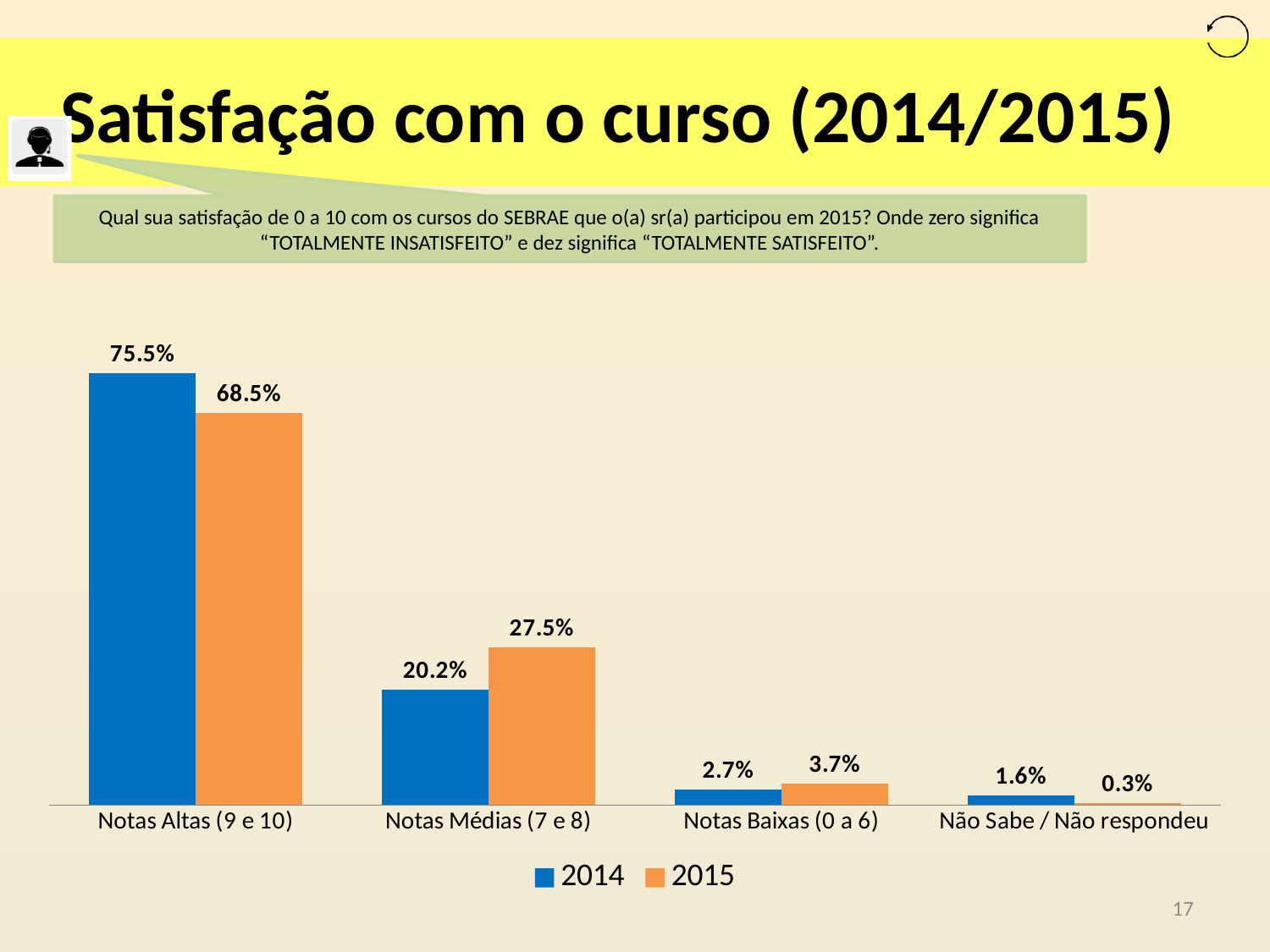
Which colour represents the 2015 series in the legend? Orange What kind of chart is shown on the slide? Bar chart What is the value for 2015 in the Não Sabe / Não respondeu category? 0.3% Which category has the highest value for 2015? Notas Altas (9 e 10) What is the value for 2014 in the Notas Altas (9 e 10) category? 75.5% How many categories are shown on the x axis? 4 Which is larger for Notas Baixas (0 a 6): the 2014 value or the 2015 value? 2015 What is the difference between the 2015 and 2014 values for Notas Médias (7 e 8)? 7.3% What is the value for 2015 in the Notas Médias (7 e 8) category? 27.5% Which category has the lowest value for 2014? Não Sabe / Não respondeu How many series does the legend list? 2 What is the difference between the 2014 and 2015 values for Notas Altas (9 e 10)? 7.0%